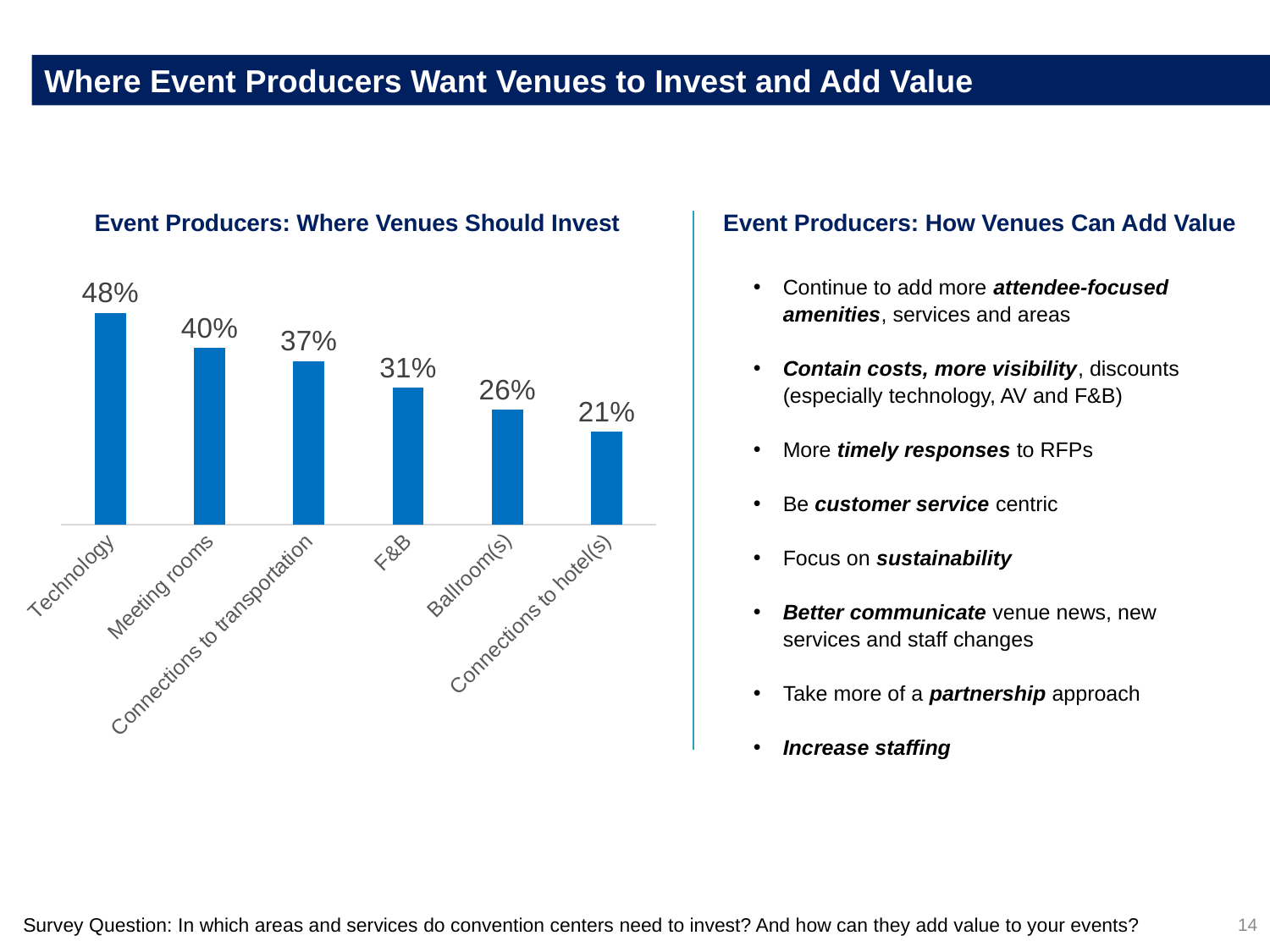
How many categories are shown in the chart? 6 Which category has the lowest value in the chart? Connections to hotel(s) What is the value shown for F&B? 31% What is the title of the chart? Event Producers: Where Venues Should Invest What is the value shown for Ballroom(s)? 26% What is the value shown for Meeting rooms? 40% What type of chart is shown on the slide? Bar chart Which is larger, the value for F&B or the value for Ballroom(s)? F&B What is the difference between the values for Technology and Connections to hotel(s)? 27% What is the value shown for Connections to transportation? 37% Which category has the highest value in the chart? Technology What percentage of event producers said venues should invest in Technology? 48%